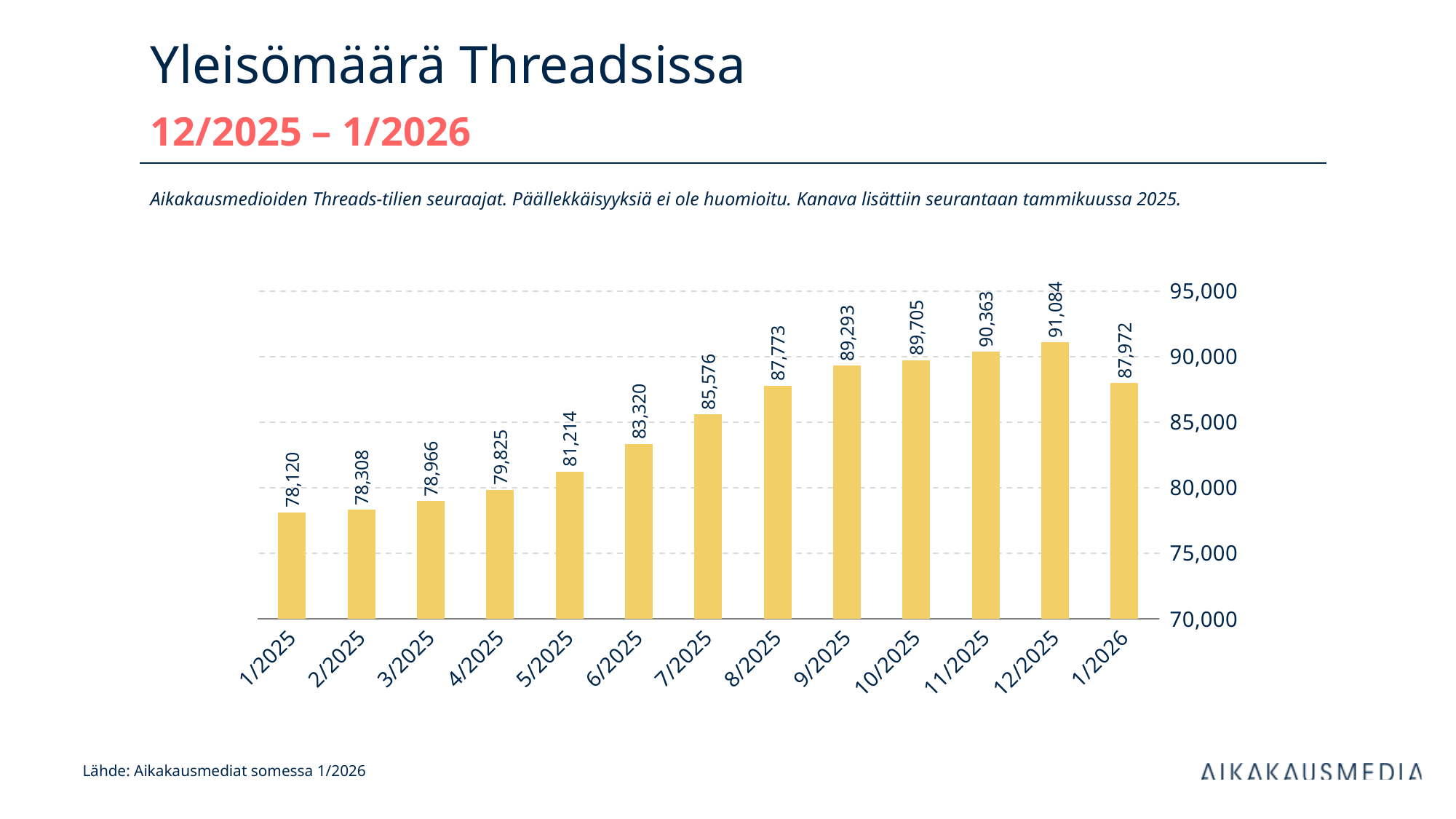
How many months are shown on the x axis? 13 Which is larger, the value for 9/2025 or the value for 1/2026? 9/2025 Do the values rise or fall from 1/2025 to 12/2025? rise Which month has the highest value? 12/2025 Is the value for 7/2025 greater or less than 85,000? greater What is the difference between the values for 12/2025 and 1/2026? 3,112 What is the value for 1/2026? 87,972 What is the value for 12/2025? 91,084 What is the value for 6/2025? 83,320 What is the difference between the values for 1/2025 and 12/2025? 12,964 What kind of chart is shown on the slide? bar chart Which month has the lowest value? 1/2025